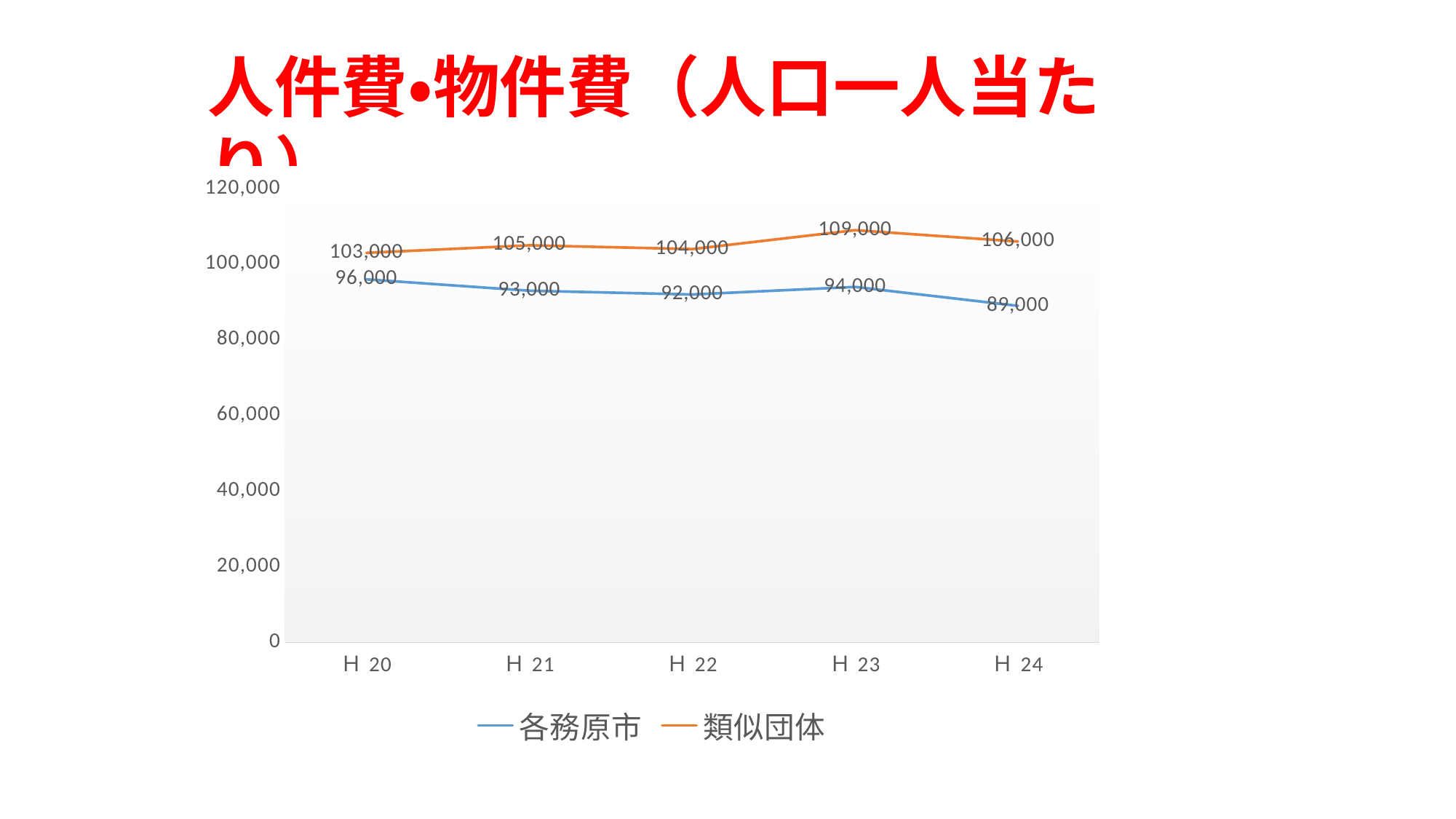
What kind of chart is shown on the slide? line chart What is the difference between 類似団体 and 各務原市 at H 24? 17,000 In which year is the 各務原市 value lowest? H 24 Does the 各務原市 line rise or fall from H 23 to H 24? fall What is the value for 各務原市 at H 24? 89,000 In which year is the 類似団体 value highest? H 23 Which series has the larger value at H 22, 各務原市 or 類似団体? 類似団体 How many years are shown on the x axis? 5 How many series does the legend list? 2 What is the value for 各務原市 at H 20? 96,000 Is the value for 各務原市 at H 21 greater or less than 100,000? less What is the value for 類似団体 at H 23? 109,000